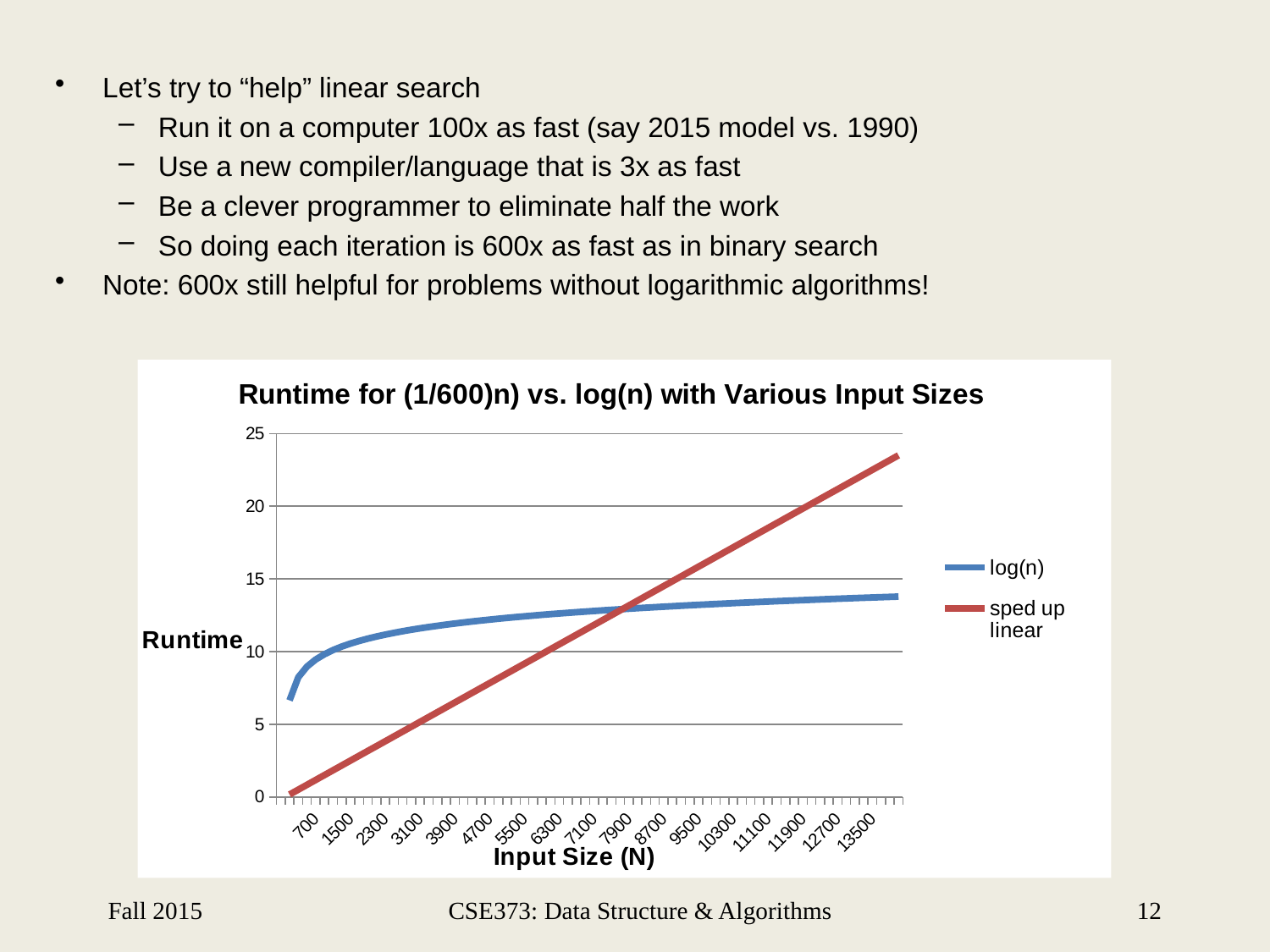
At input size 13500, which series has the higher runtime, 'log(n)' or 'sped up linear'? sped up linear Does the 'sped up linear' series rise or fall as input size increases? rise Is the value of 'sped up linear' at input size 2300 greater or less than 5? less What kind of chart is shown on the slide? line chart Does the 'log(n)' series rise or fall as input size increases? rise Is the value of 'log(n)' at input size 13500 greater or less than 15? less What is the title of the chart? Runtime for (1/600)n) vs. log(n) with Various Input Sizes How many series does the legend list? 2 Is the value of 'sped up linear' at input size 13500 greater or less than 20? greater At input size 700, which series has the higher runtime, 'log(n)' or 'sped up linear'? log(n) What colour is the line for the 'sped up linear' series? red